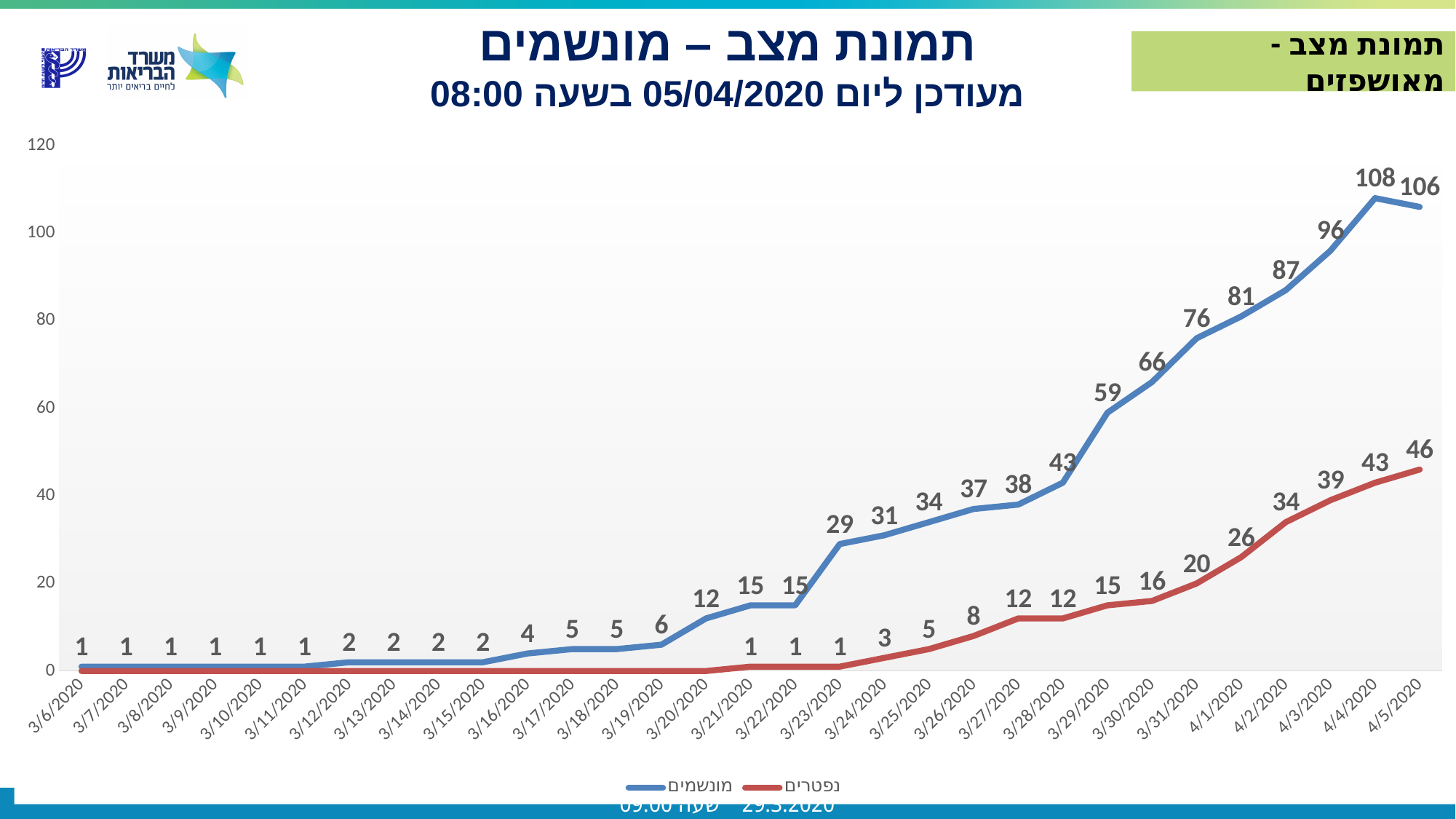
What is the difference between the מונשמים and נפטרים values on 4/5/2020? 60 Does the נפטרים series generally rise or fall from 3/21/2020 to 4/5/2020? rise What is the difference between the מונשמים value on 4/4/2020 and on 4/5/2020? 2 What type of chart is shown on the slide? line chart How many dates are shown on the x axis? 31 On which date does the מונשמים series reach its highest value? 4/4/2020 What is the value of the נפטרים series on 4/5/2020? 46 Which series has the higher value on 4/2/2020, מונשמים or נפטרים? מונשמים How many series does the legend list? 2 What is the value of the מונשמים series on 4/4/2020? 108 What is the value of the נפטרים series on 3/31/2020? 20 What is the value of the מונשמים series on 3/23/2020? 29